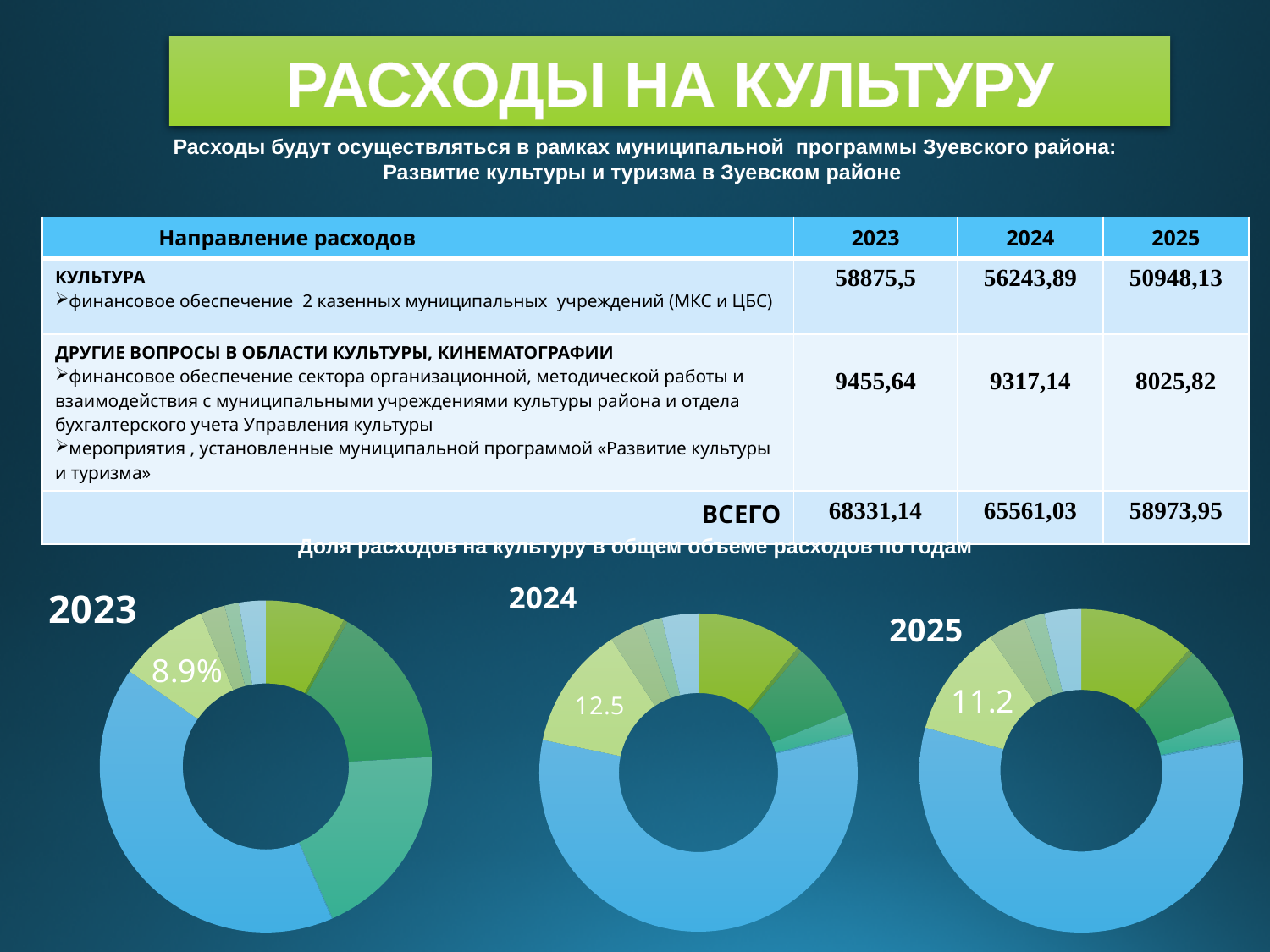
Is the labelled share in the 2024 chart larger or smaller than the labelled share in the 2025 chart? larger In the 2024 chart, what value is printed on the labelled slice? 12.5 In the 2025 chart, what value is printed on the labelled slice? 11.2 In the 2023 chart, what value is printed on the labelled slice? 8.9% What is the difference between the labelled share in the 2024 chart (12.5) and the labelled share in the 2025 chart (11.2)? 1.3 Does the labelled share of culture spending rise or fall from the 2023 chart to the 2024 chart? rise In each of the three doughnut charts, what colour is the largest slice? blue Which year's chart shows the smallest labelled share for culture spending? 2023 Which year's chart shows the largest labelled share for culture spending? 2024 What kind of chart is used for the 2023, 2024 and 2025 charts at the bottom of the slide? doughnut (pie) chart How many doughnut charts are shown on the slide? 3 What is the heading printed above the three doughnut charts? Доля расходов на культуру в общем объеме расходов по годам